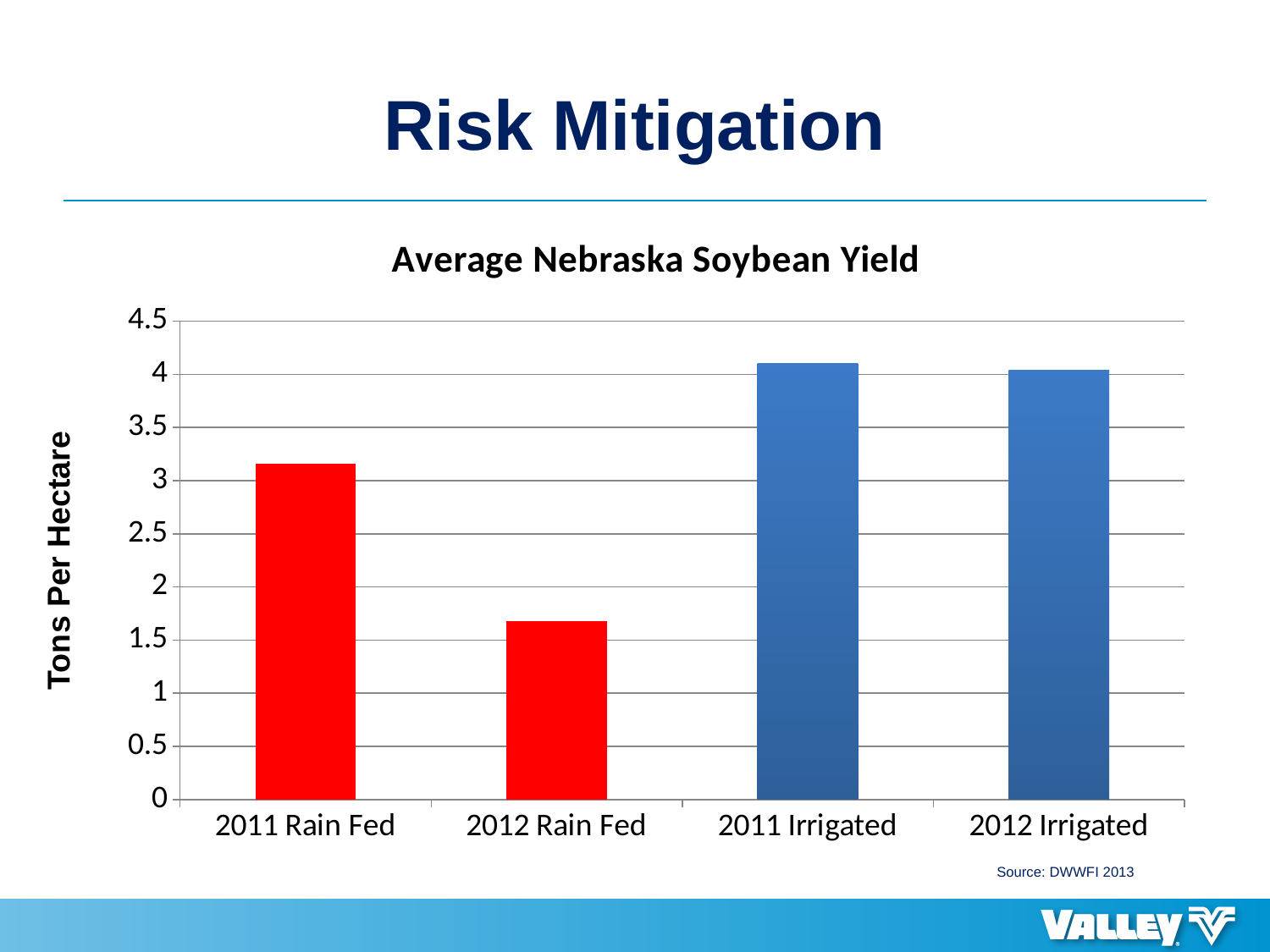
Is the value for 2012 Rain Fed greater or less than 2? less Which category has the lowest average soybean yield? 2012 Rain Fed How many categories are shown on the x axis of the chart? 4 What is the label on the vertical axis of the chart? Tons Per Hectare What is the title of the chart? Average Nebraska Soybean Yield Is the value for 2012 Irrigated greater or less than 3.5? greater Is the value for 2011 Rain Fed greater or less than 3? greater What type of chart is shown on the slide? Bar chart Which is larger, the value for 2012 Rain Fed or the value for 2012 Irrigated? 2012 Irrigated Which is larger, the value for 2011 Rain Fed or the value for 2012 Rain Fed? 2011 Rain Fed